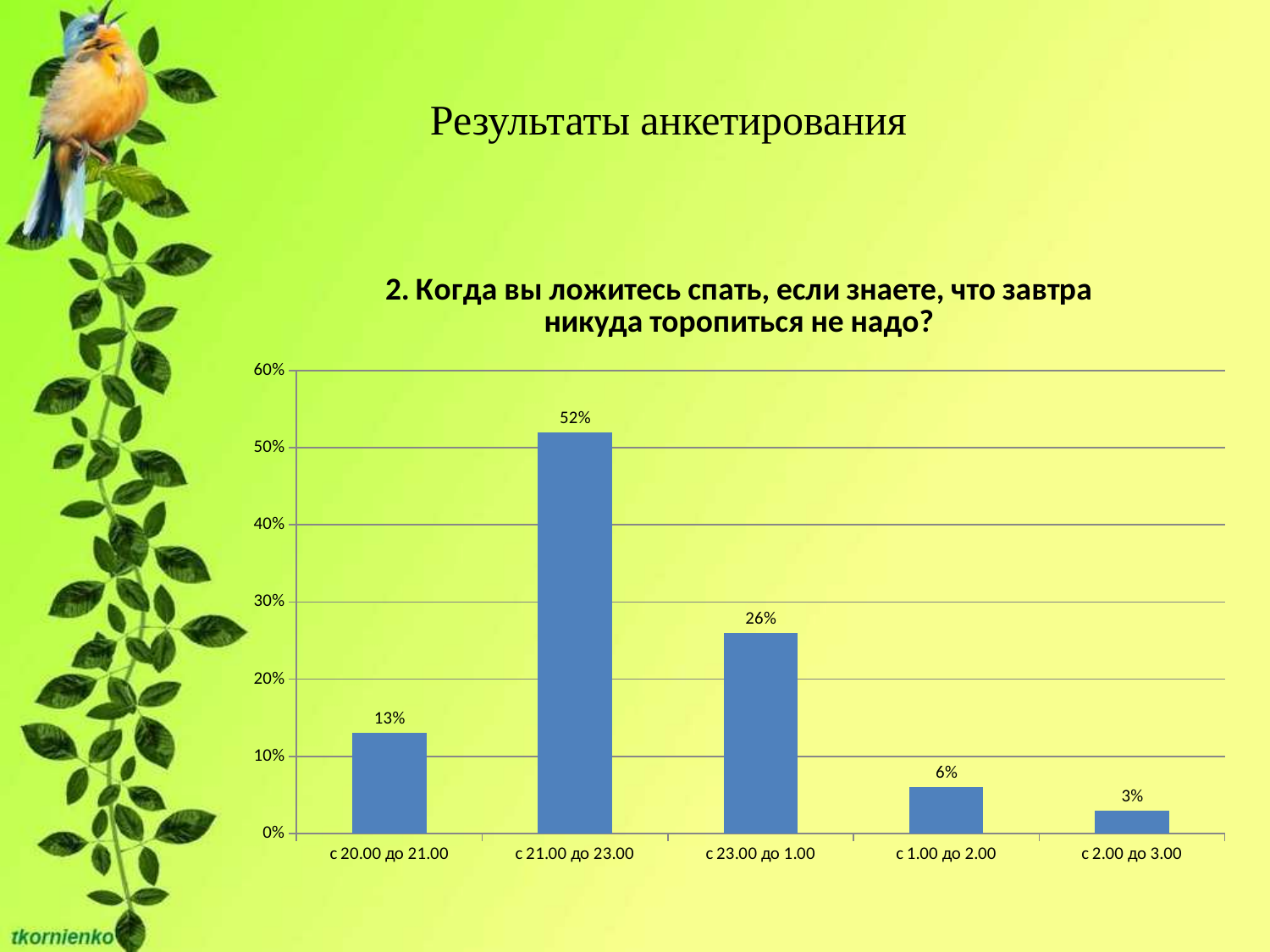
What is the value for the category с 20.00 до 21.00? 13% What is the value for the category с 2.00 до 3.00? 3% Is the value for с 23.00 до 1.00 greater or less than 30%? less Which is larger: the value for с 23.00 до 1.00 or the value for с 20.00 до 21.00? с 23.00 до 1.00 What kind of chart is shown on the slide? bar chart What percentage of respondents go to bed с 21.00 до 23.00? 52% What is the difference between the values for с 20.00 до 21.00 and с 1.00 до 2.00? 7% What is the title of the chart? 2. Когда вы ложитесь спать, если знаете, что завтра никуда торопиться не надо? Which category has the lowest value? с 2.00 до 3.00 How many categories are shown on the x axis? 5 Which category has the highest value? с 21.00 до 23.00 What is the difference between the values for с 21.00 до 23.00 and с 23.00 до 1.00? 26%